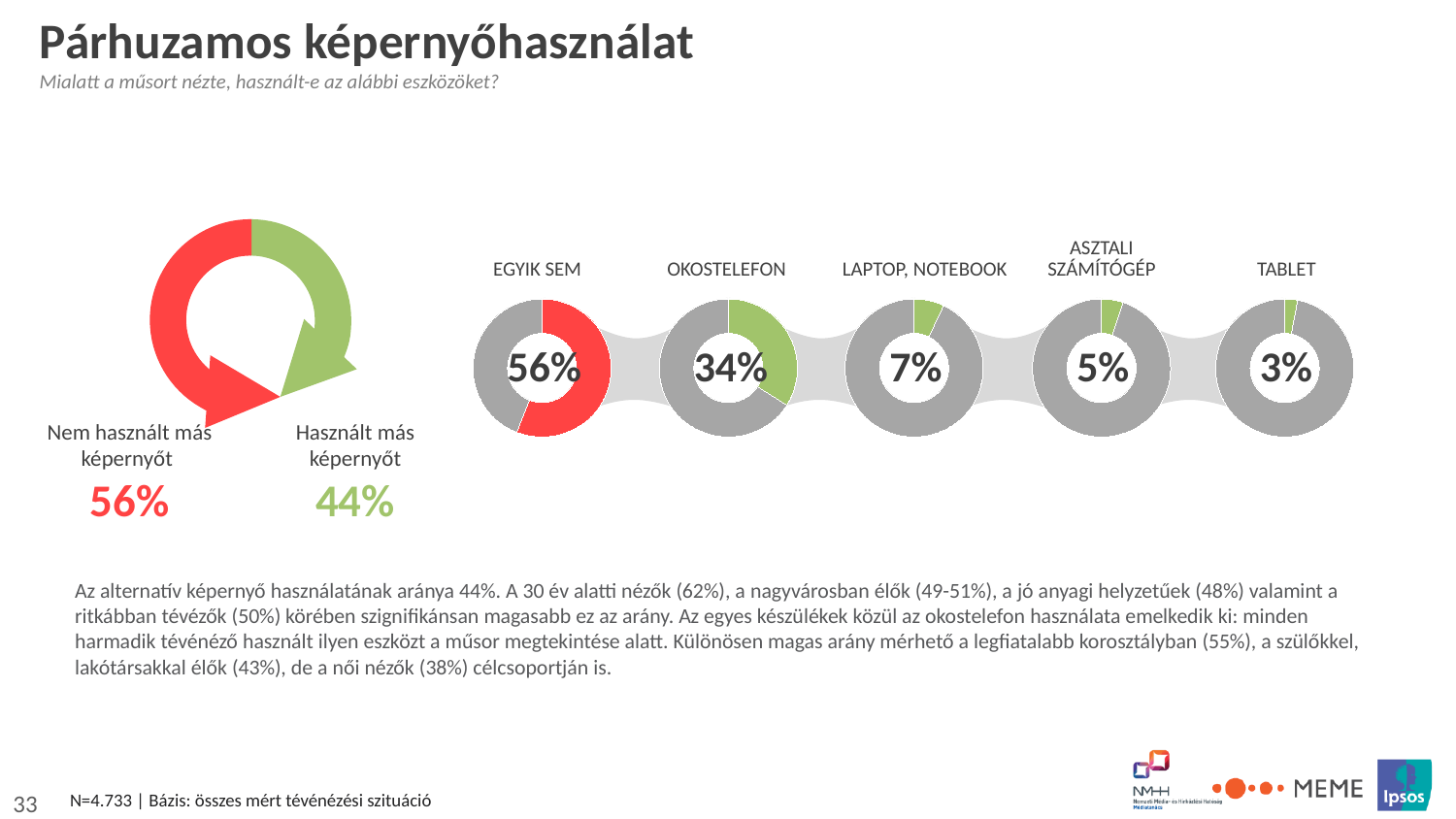
In the row of small donut charts on the right, which device category has the lowest value? TABLET In the large donut chart on the left, what share is labelled "Használt más képernyőt"? 44% In the row of small donut charts on the right, what is the difference between the OKOSTELEFON and TABLET values? 31 percentage points In the large donut chart on the left, what share is labelled "Nem használt más képernyőt"? 56% In the large donut chart on the left, what is the difference between the "Nem használt más képernyőt" and "Használt más képernyőt" shares? 12 percentage points In the row of small donut charts on the right, which category has the highest value? EGYIK SEM In the row of small donut charts on the right, what value is shown for OKOSTELEFON? 34% In the row of small donut charts on the right, what value is shown for LAPTOP, NOTEBOOK? 7% In the row of small donut charts on the right, how many categories are shown? 5 In the row of small donut charts on the right, what value is shown for ASZTALI SZÁMÍTÓGÉP? 5% In the large donut chart on the left, which segment is larger: "Nem használt más képernyőt" or "Használt más képernyőt"? Nem használt más képernyőt What kind of chart is the large chart on the left of the slide? Donut (pie) chart